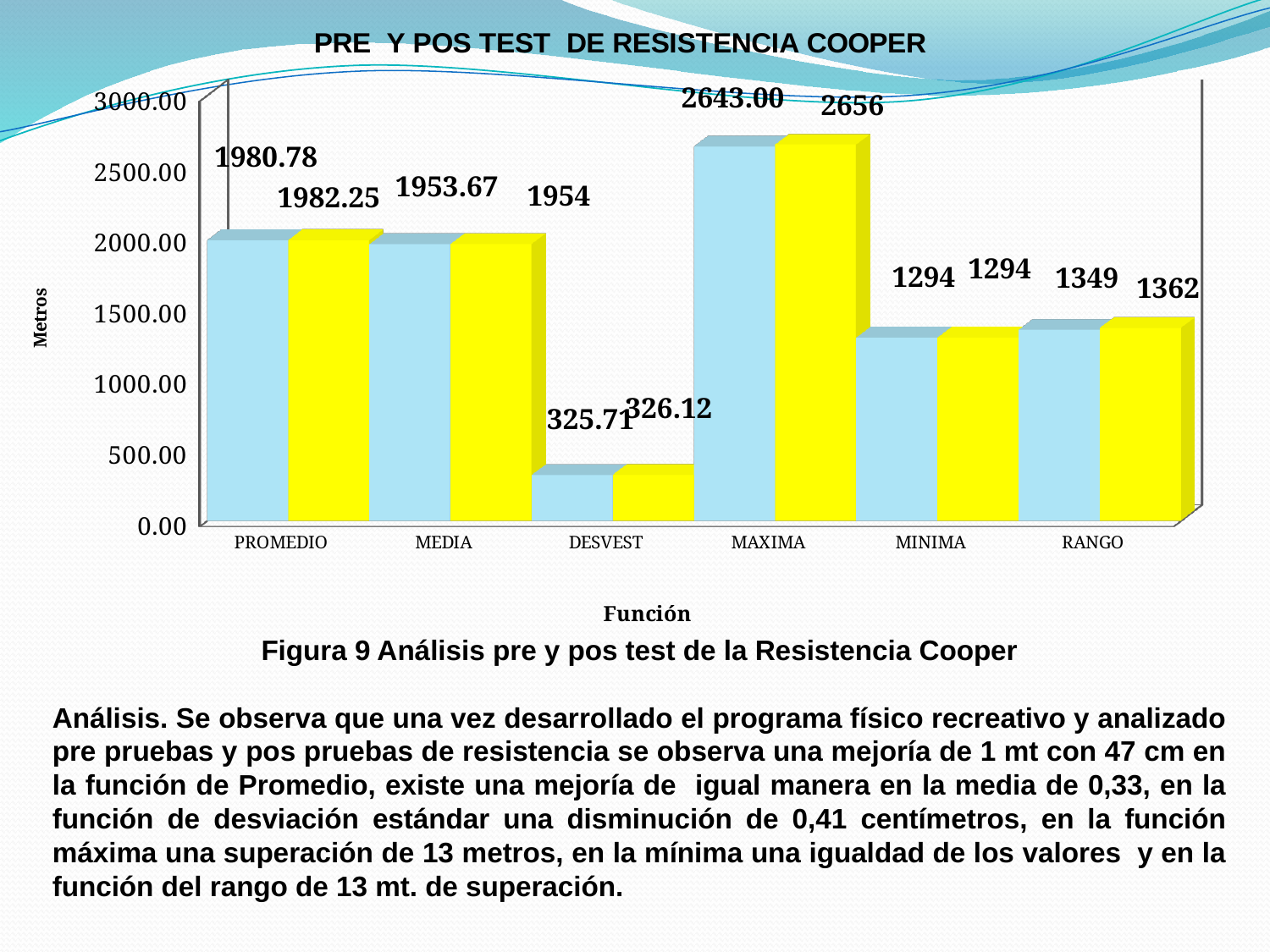
Which category has the highest values on the chart? MAXIMA What is the value of the blue (first) bar for MAXIMA? 2643.00 What type of chart is shown on the slide? Bar chart What is the difference between the yellow bar and the blue bar for MAXIMA? 13 What is the value of the blue (first) bar for DESVEST? 325.71 What is the value of the yellow (second) bar for PROMEDIO? 1982.25 What is the value of the yellow (second) bar for RANGO? 1362 Which category has the lowest values on the chart? DESVEST How many categories are shown on the x axis? 6 What is the difference between the yellow bar and the blue bar for RANGO? 13 Is the value of the blue bar for MEDIA greater or less than 1500.00? greater Which is larger, the blue bar for MINIMA or the blue bar for RANGO? RANGO